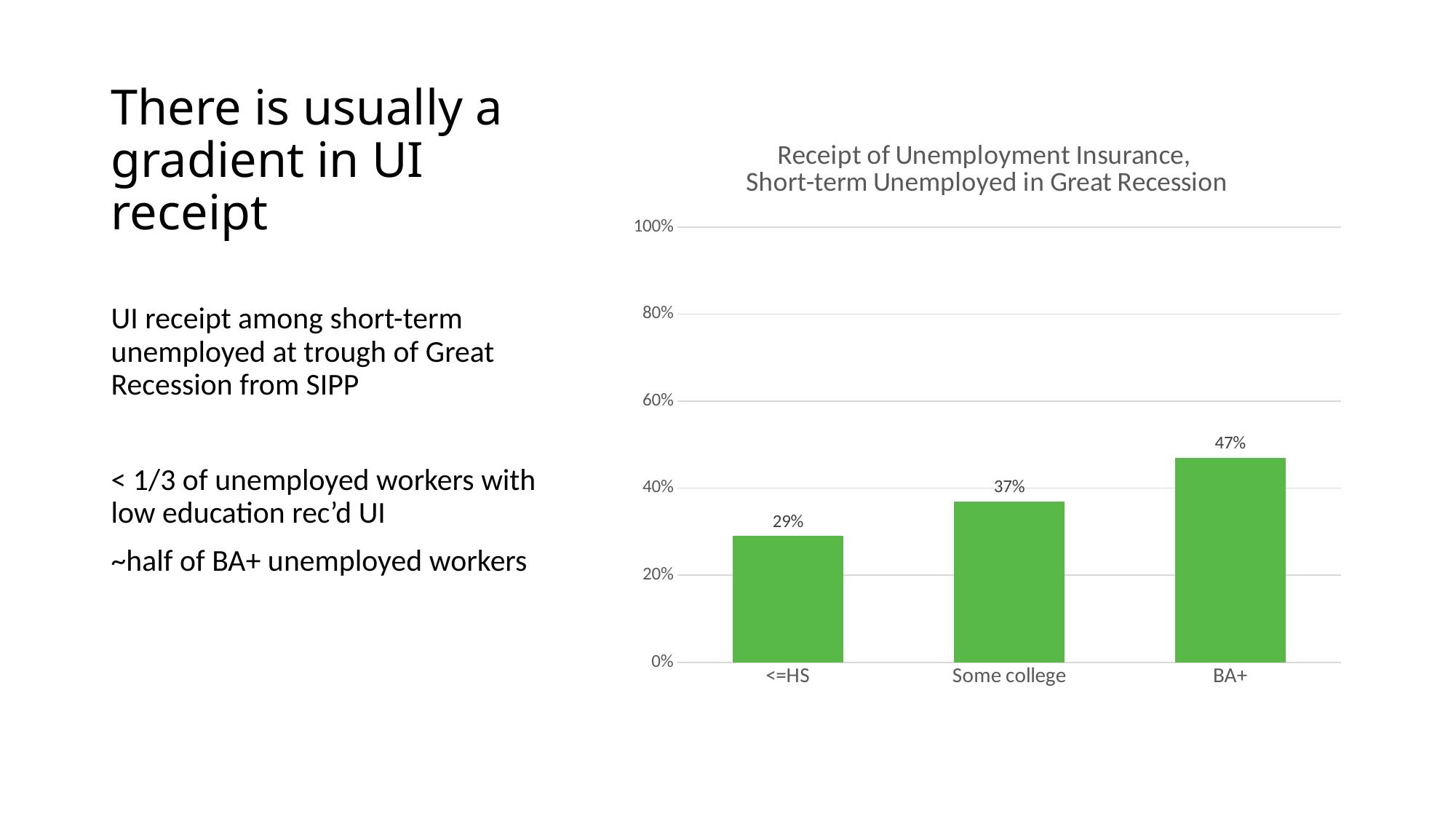
Which category has the lowest value? <=HS What is the difference between the values for Some college and <=HS? 8% Do the values rise or fall from <=HS to BA+? rise What is the value for <=HS? 29% What is the value for Some college? 37% What kind of chart is shown on the slide? bar chart What is the value for BA+? 47% How many categories are shown on the x axis? 3 Which category has the highest value? BA+ What is the difference between the values for BA+ and <=HS? 18% Which is larger, the value for Some college or the value for BA+? BA+ Is the value for BA+ greater or less than 40%? greater